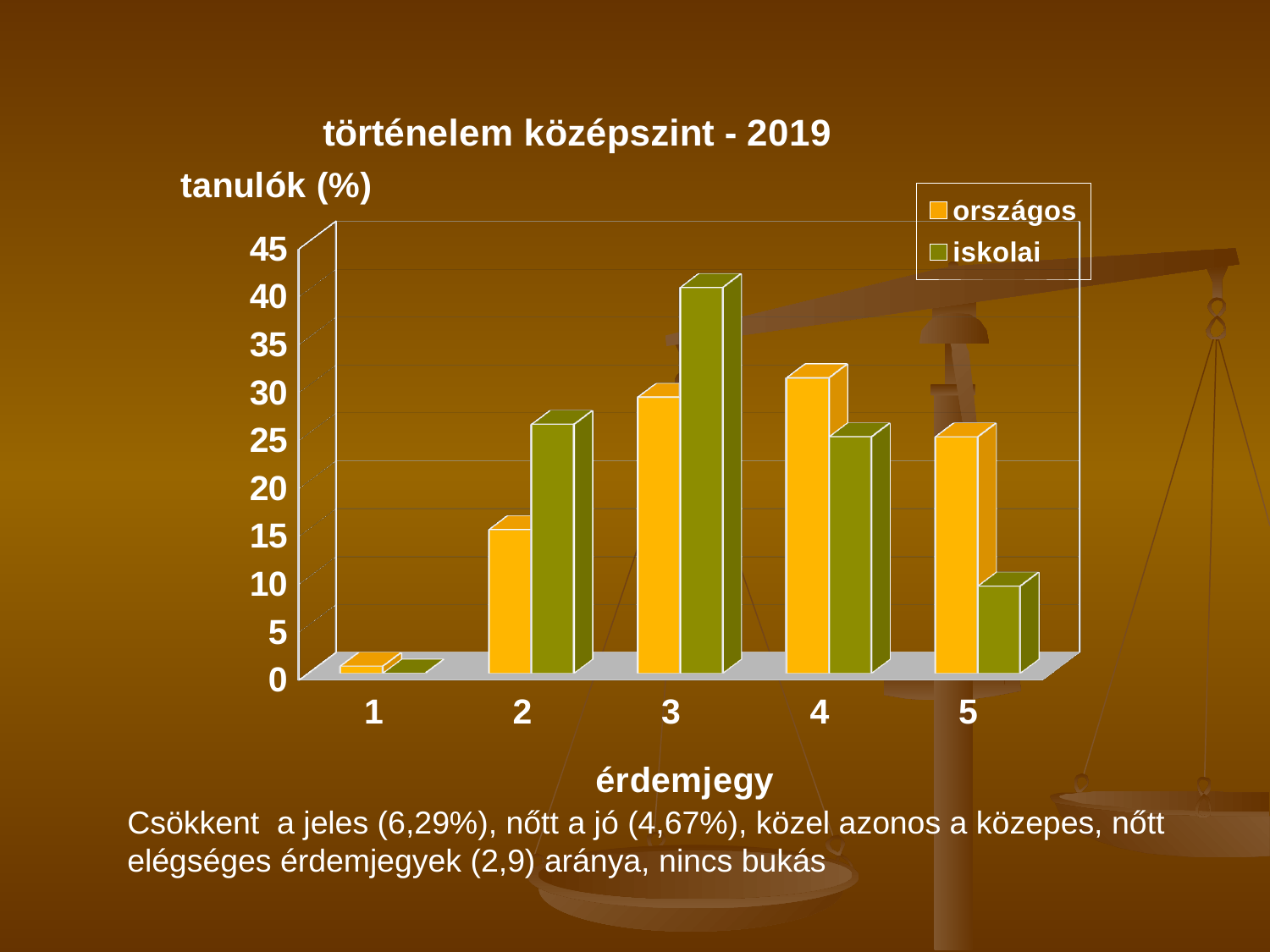
What are the two series named in the legend? országos, iskolai For which grade is the iskolai value lowest? 1 Is the országos value for grade 2 greater or less than 20? less How many grade categories (érdemjegy) are shown on the x axis? 5 For which grade is the iskolai value highest? 3 For grade 2, which is larger: the országos value or the iskolai value? iskolai For grade 5, which is larger: the országos value or the iskolai value? országos Is the iskolai value for grade 5 greater or less than 15? less What is the title of the chart? történelem középszint - 2019 How many series does the legend list? 2 What kind of chart is shown on the slide? bar chart Is the iskolai value for grade 3 greater or less than 35? greater